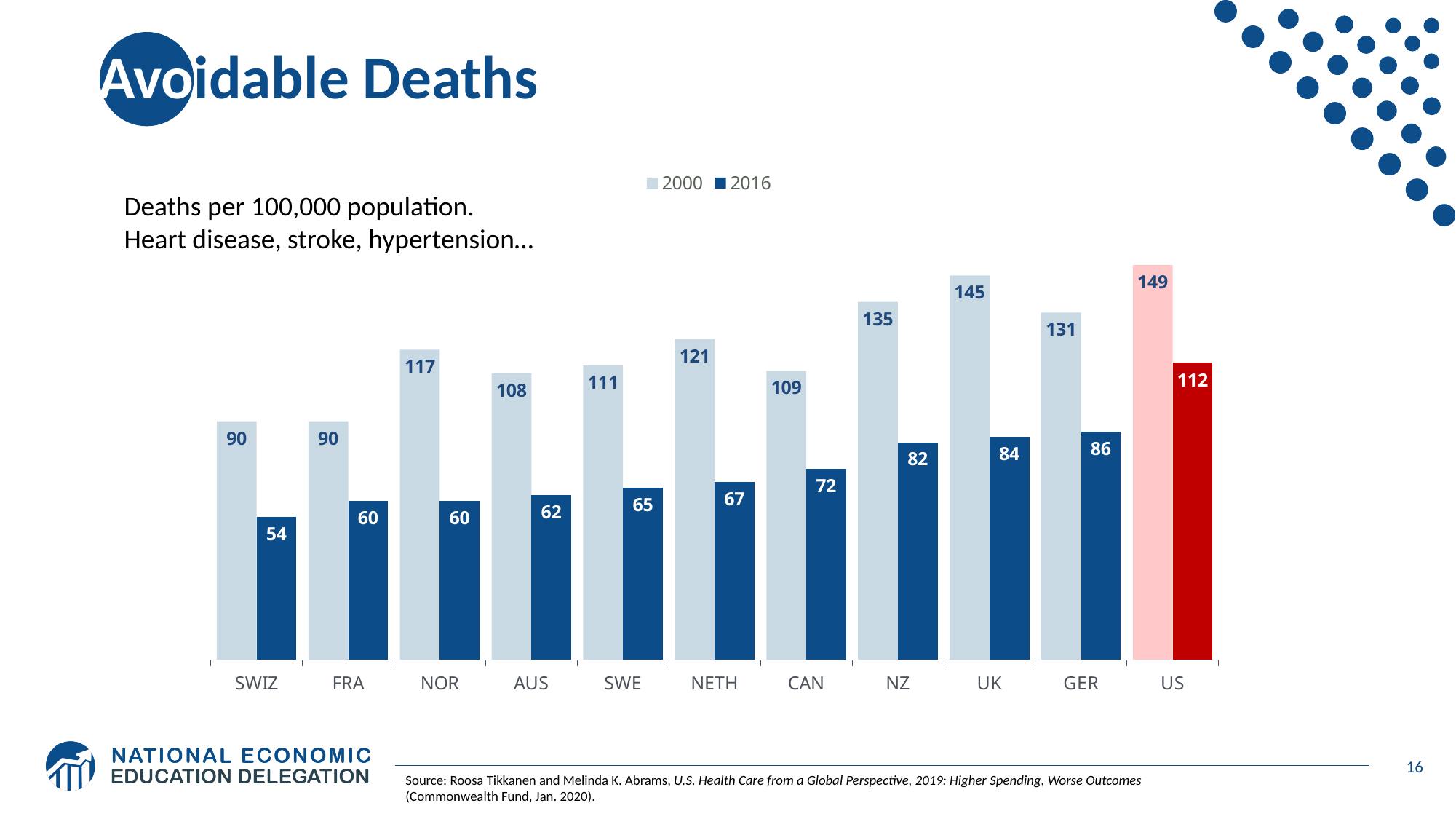
Which country has the lowest 2016 value? SWIZ Which is larger, the 2016 value for GER or the 2016 value for CAN? GER How many series does the legend list? 2 What are the two series listed in the legend? 2000 and 2016 How many countries are shown on the x axis? 11 What kind of chart is shown on the slide? Bar chart What is the 2016 value for SWIZ? 54 What is the 2000 value for NOR? 117 What is the difference between the 2000 and 2016 values for the UK? 61 Which country has the highest 2000 value? US Which country's bars are coloured red instead of blue? US What is the 2016 value for the US? 112